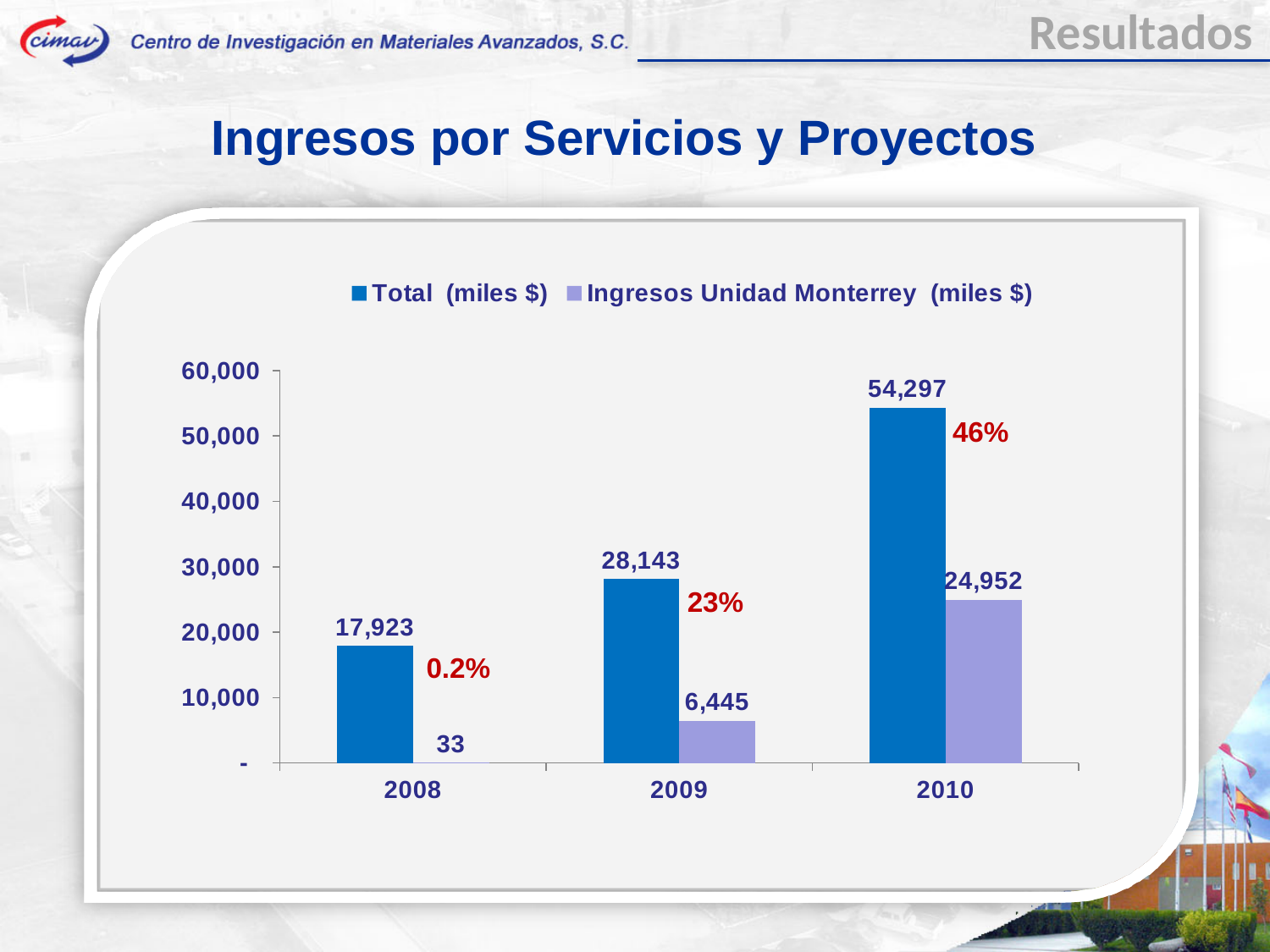
What kind of chart is shown on the slide? bar chart Is the Total (miles $) for 2008 greater or less than 20,000? less Which is larger: Total (miles $) in 2009 or Ingresos Unidad Monterrey (miles $) in 2010? Total (miles $) in 2009 How many series does the legend list? 2 Which year has the lowest Ingresos Unidad Monterrey (miles $)? 2008 What is the value of Ingresos Unidad Monterrey (miles $) for 2009? 6,445 What is the difference between Total (miles $) in 2010 and 2009? 26,154 What is the value of Total (miles $) for 2010? 54,297 What percentage label is shown in red next to the 2010 bars? 46% How many years are shown on the x axis? 3 What is the value of Ingresos Unidad Monterrey (miles $) for 2008? 33 Which year has the highest Total (miles $)? 2010